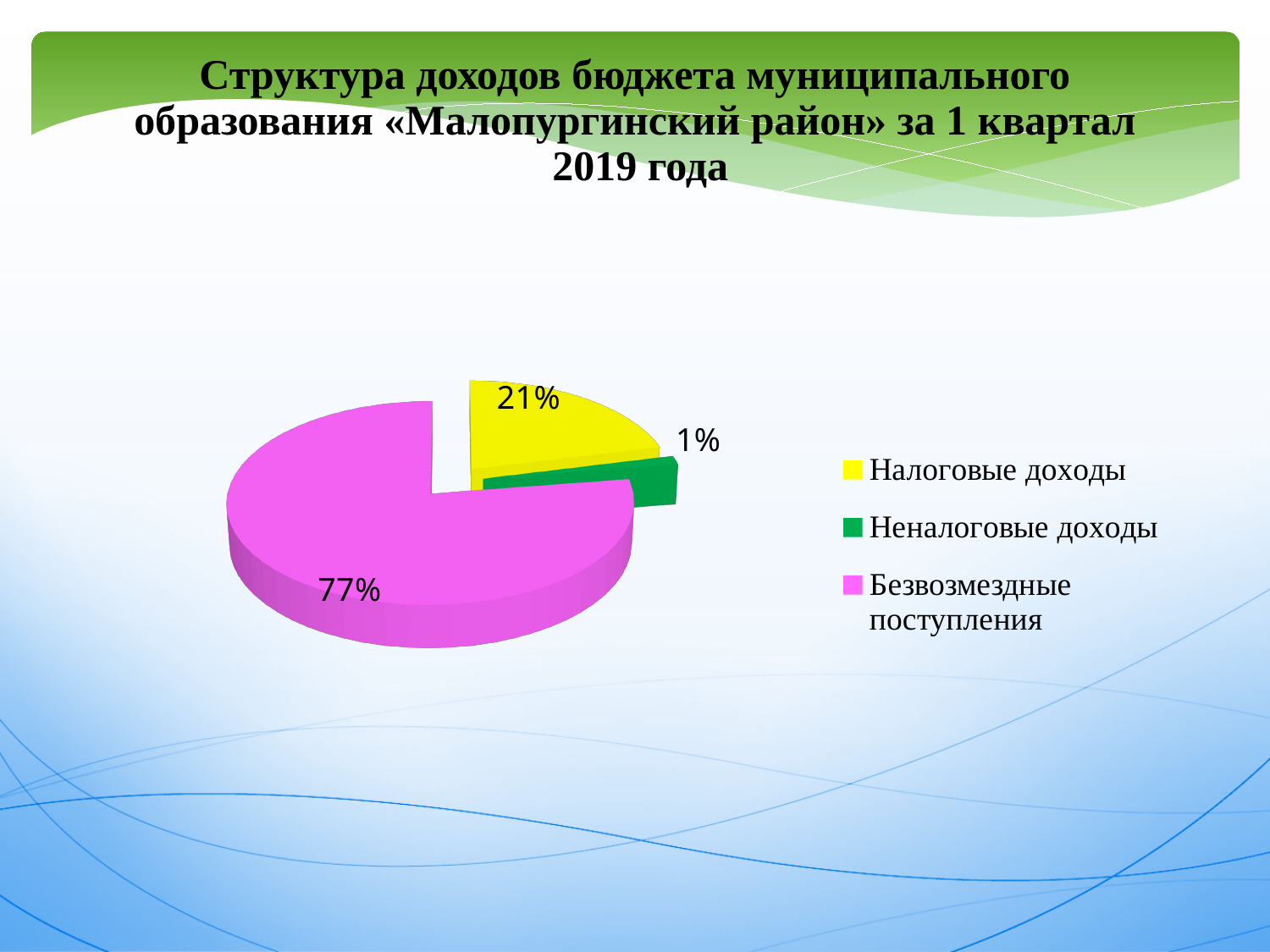
What share of the pie does Безвозмездные поступления take? 77% Which category is shown in yellow in the legend? Налоговые доходы Which category has the smallest slice of the pie? Неналоговые доходы What colour is the slice for Безвозмездные поступления? pink What is the difference between the shares of Налоговые доходы and Неналоговые доходы? 20% What is the value shown for Налоговые доходы? 21% Which is larger, the share of Налоговые доходы or the share of Неналоговые доходы? Налоговые доходы What is the difference between the shares of Безвозмездные поступления and Налоговые доходы? 56% How many categories does the pie chart have? 3 What is the value shown for Неналоговые доходы? 1% Which category has the largest slice of the pie? Безвозмездные поступления What kind of chart is shown on the slide? pie chart